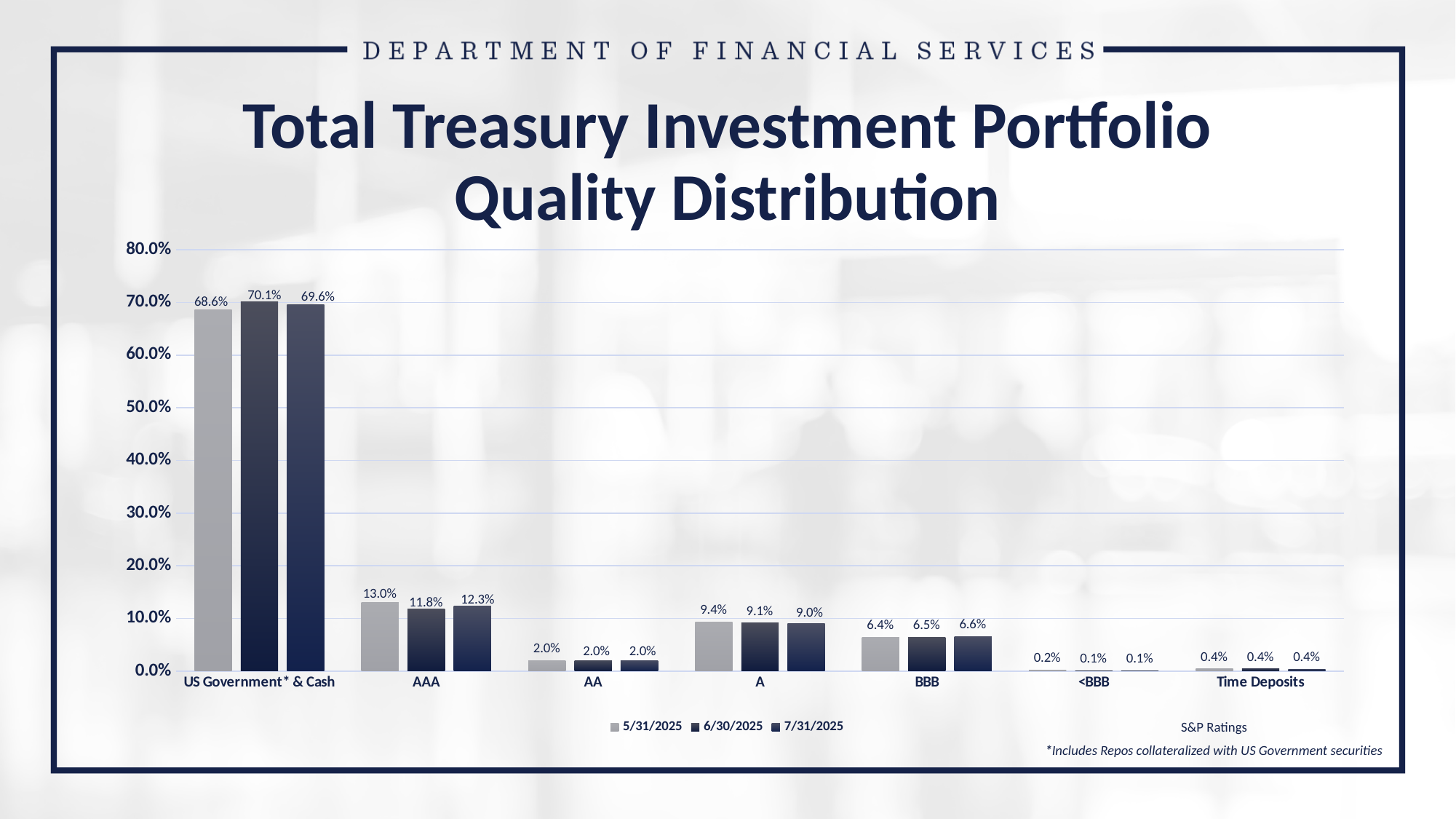
How many categories are shown on the x axis? 7 What is the difference between the 5/31/2025 and 7/31/2025 values for AAA? 0.7% What is the value for AAA in the 5/31/2025 series? 13.0% What is the value for US Government* & Cash in the 6/30/2025 series? 70.1% What is the value for <BBB in the 5/31/2025 series? 0.2% What kind of chart is shown on the slide? Bar chart Which category has the lowest value in the 6/30/2025 series? <BBB How many series does the legend list? 3 What is the title of the chart? Total Treasury Investment Portfolio Quality Distribution Which is larger for the A category: the 5/31/2025 value or the 7/31/2025 value? 5/31/2025 What is the value for BBB in the 7/31/2025 series? 6.6% Which category has the highest value in the 7/31/2025 series? US Government* & Cash